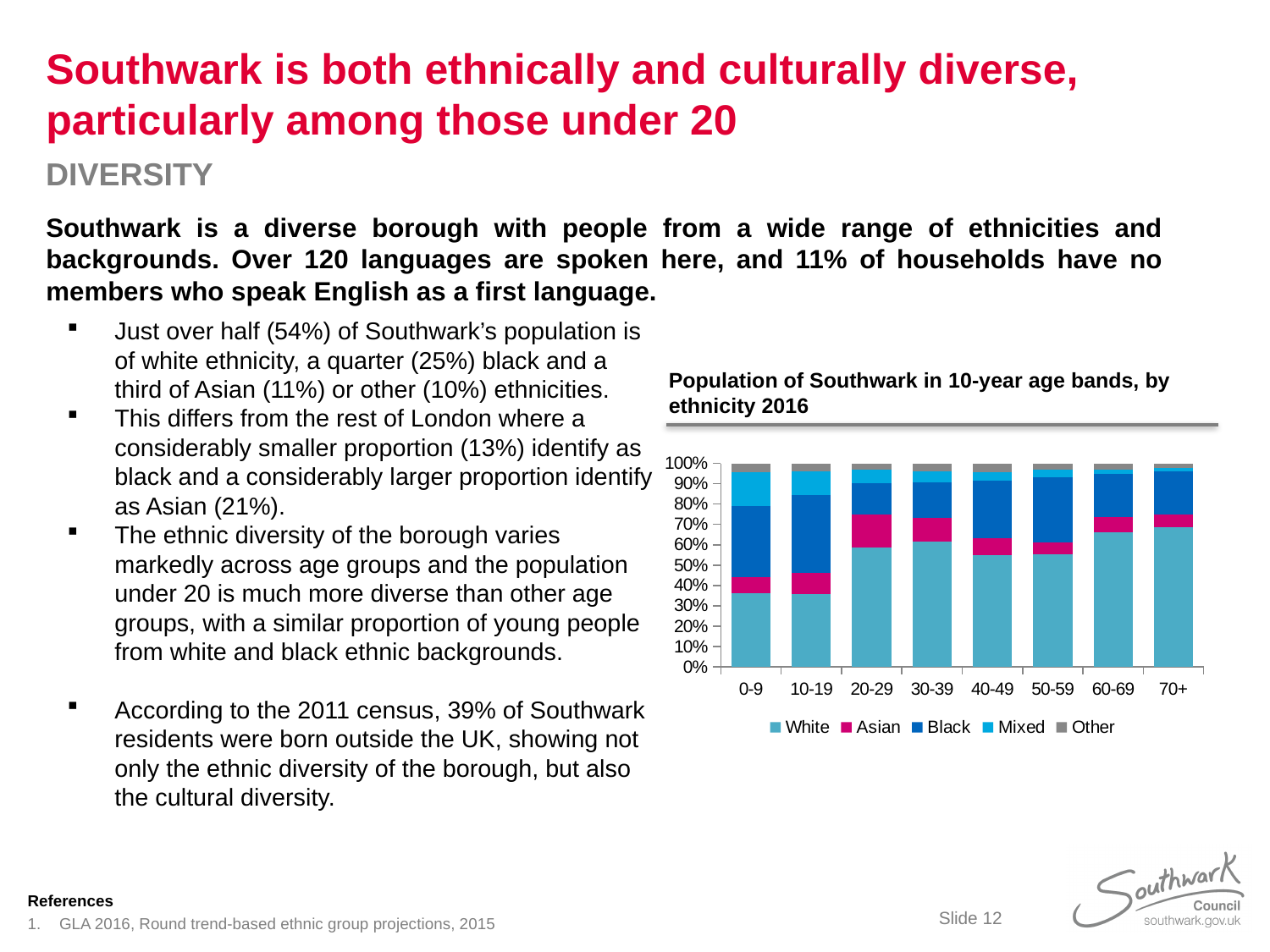
Which ethnic group is listed first in the chart's legend? White How many age bands are shown on the x axis of the chart? 8 Is the White share for the 0-9 age band greater or less than 40%? less Which age band has the largest Mixed share? 0-9 Does the White share generally rise or fall as the age bands increase from 0-9 to 70+? rise How many ethnic groups does the chart's legend list? 5 Which age band has the larger Black share, 0-9 or 70+? 0-9 Is the White share for the 20-29 age band greater or less than 50%? greater Which age band has the larger White share, 0-9 or 70+? 70+ Is the White share for the 70+ age band greater or less than 60%? greater What kind of chart is shown on the slide? Stacked bar chart What is the title of the chart? Population of Southwark in 10-year age bands, by ethnicity 2016